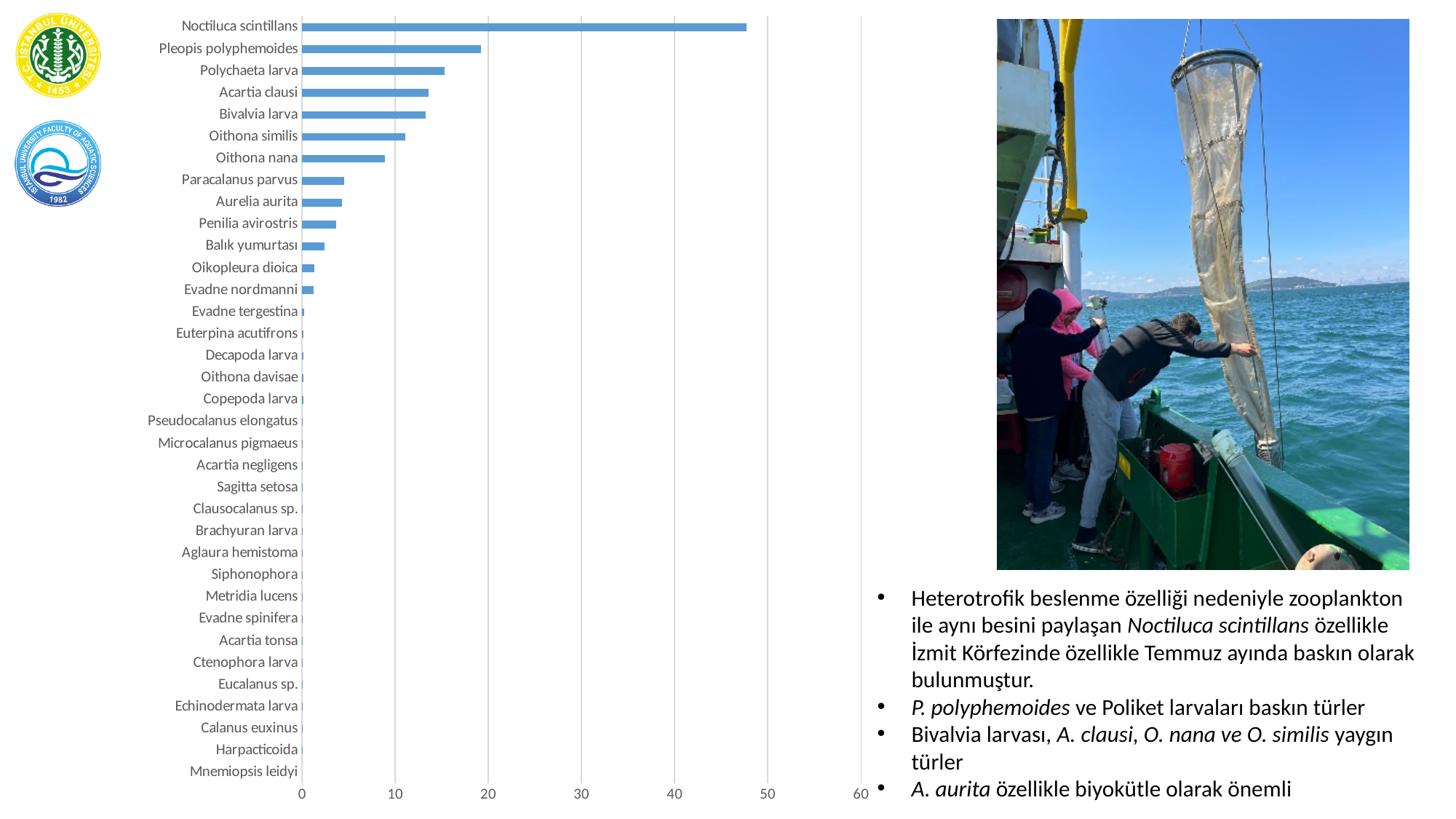
Is the value for Polychaeta larva greater or less than 10? greater Which has a larger value, Polychaeta larva or Oithona nana? Polychaeta larva Is the value for Paracalanus parvus greater or less than 10? less What kind of chart is shown on the slide? bar chart How many categories are listed on the vertical axis of the bar chart? 35 Which category has the highest value in the bar chart? Noctiluca scintillans Is the value for Noctiluca scintillans greater or less than 40? greater Do the bar values increase or decrease going from the top category to the bottom category? decrease Which has a larger value, Noctiluca scintillans or Pleopis polyphemoides? Noctiluca scintillans